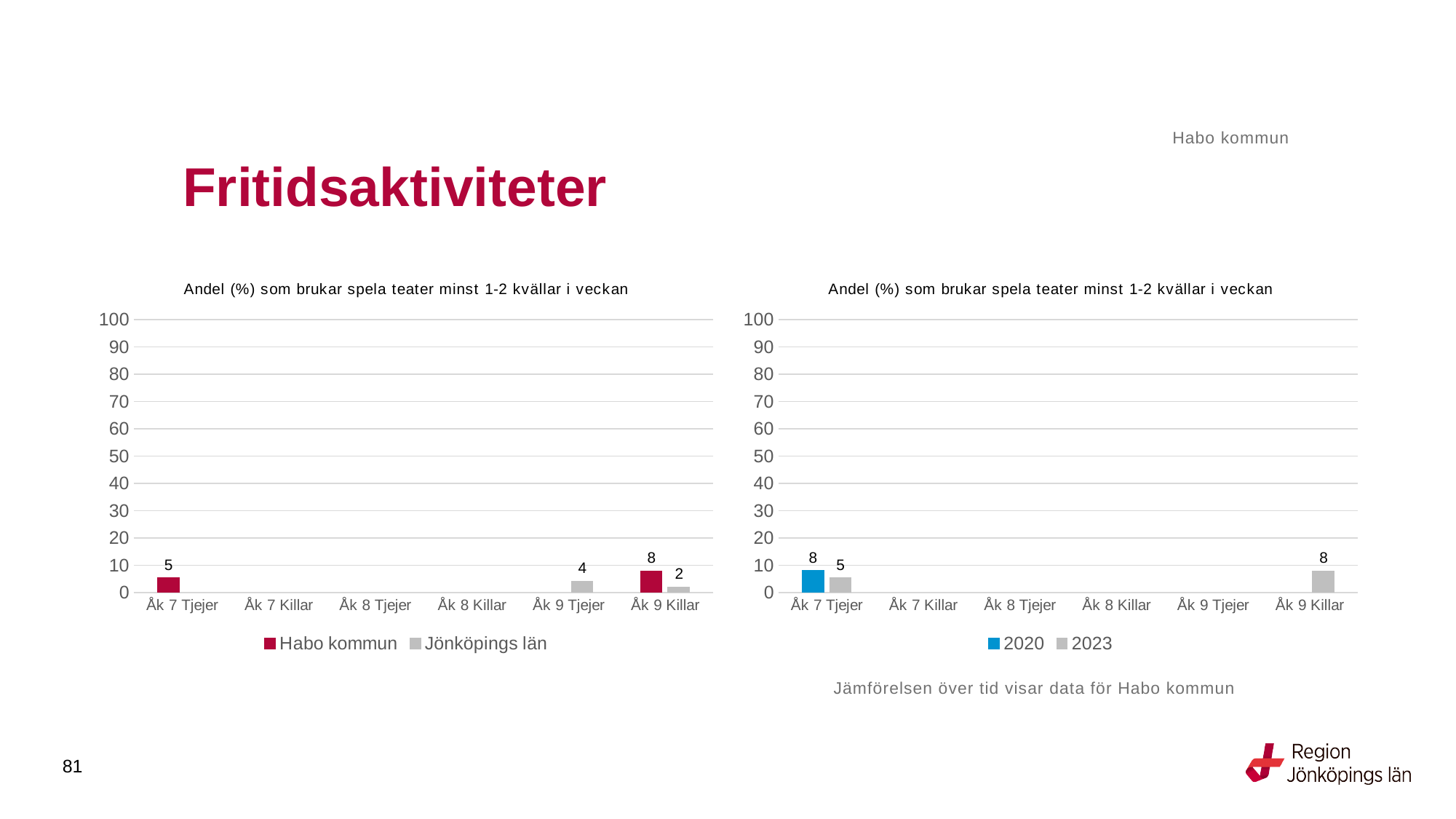
In the left chart, what is the value for Jönköpings län for Åk 9 Tjejer? 4 In the right chart, what is the value for 2023 for Åk 9 Killar? 8 In the left chart, what is the value for Habo kommun for Åk 9 Killar? 8 What kind of chart is the left chart? Bar chart In the left chart, what is the value for Habo kommun for Åk 7 Tjejer? 5 In the right chart, which is larger for Åk 7 Tjejer, 2020 or 2023? 2020 In the left chart, how many series does the legend list? 2 In the right chart, what is the difference between 2020 and 2023 for Åk 7 Tjejer? 3 How many categories are shown on the x axis of the right chart? 6 In the right chart, what is the value for 2020 for Åk 7 Tjejer? 8 In the left chart, what is the difference between Habo kommun and Jönköpings län for Åk 9 Killar? 6 In the left chart, which is larger for Åk 9 Killar, Habo kommun or Jönköpings län? Habo kommun